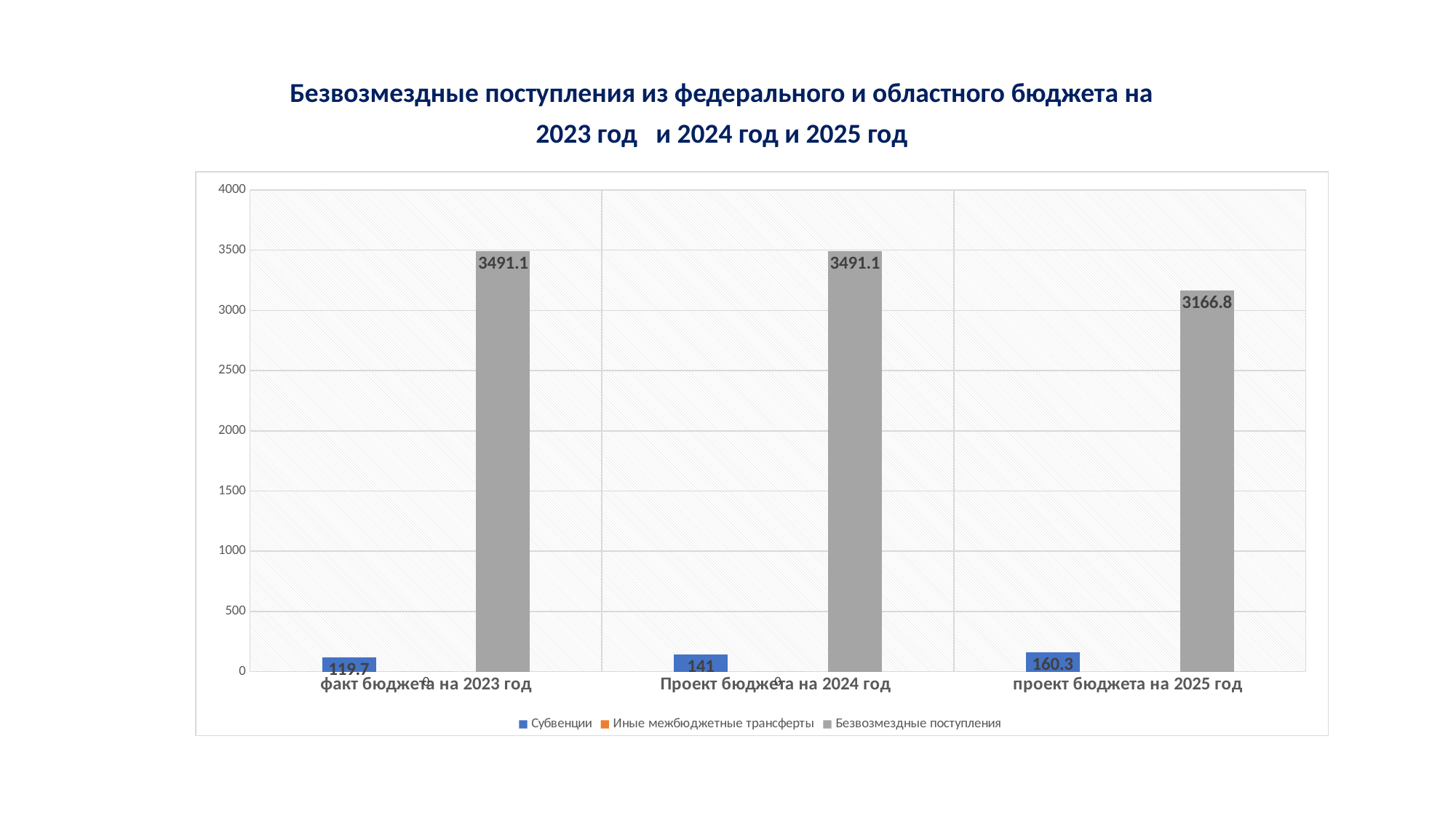
What is the difference between Субвенции for проект бюджета на 2025 год and факт бюджета на 2023 год? 40.6 What is the value of Безвозмездные поступления for факт бюджета на 2023 год? 3491.1 Which category has the highest value for Субвенции? проект бюджета на 2025 год What is the value of Субвенции for проект бюджета на 2025 год? 160.3 What is the value of Безвозмездные поступления for проект бюджета на 2025 год? 3166.8 Which category has the lowest value for Безвозмездные поступления? проект бюджета на 2025 год What is the difference between Безвозмездные поступления for Проект бюджета на 2024 год and проект бюджета на 2025 год? 324.3 How many series does the legend list? 3 What is the value of Субвенции for Проект бюджета на 2024 год? 141 What kind of chart is shown on the slide? bar chart Which is larger: Субвенции for факт бюджета на 2023 год or Субвенции for Проект бюджета на 2024 год? Проект бюджета на 2024 год How many categories are shown on the x axis? 3